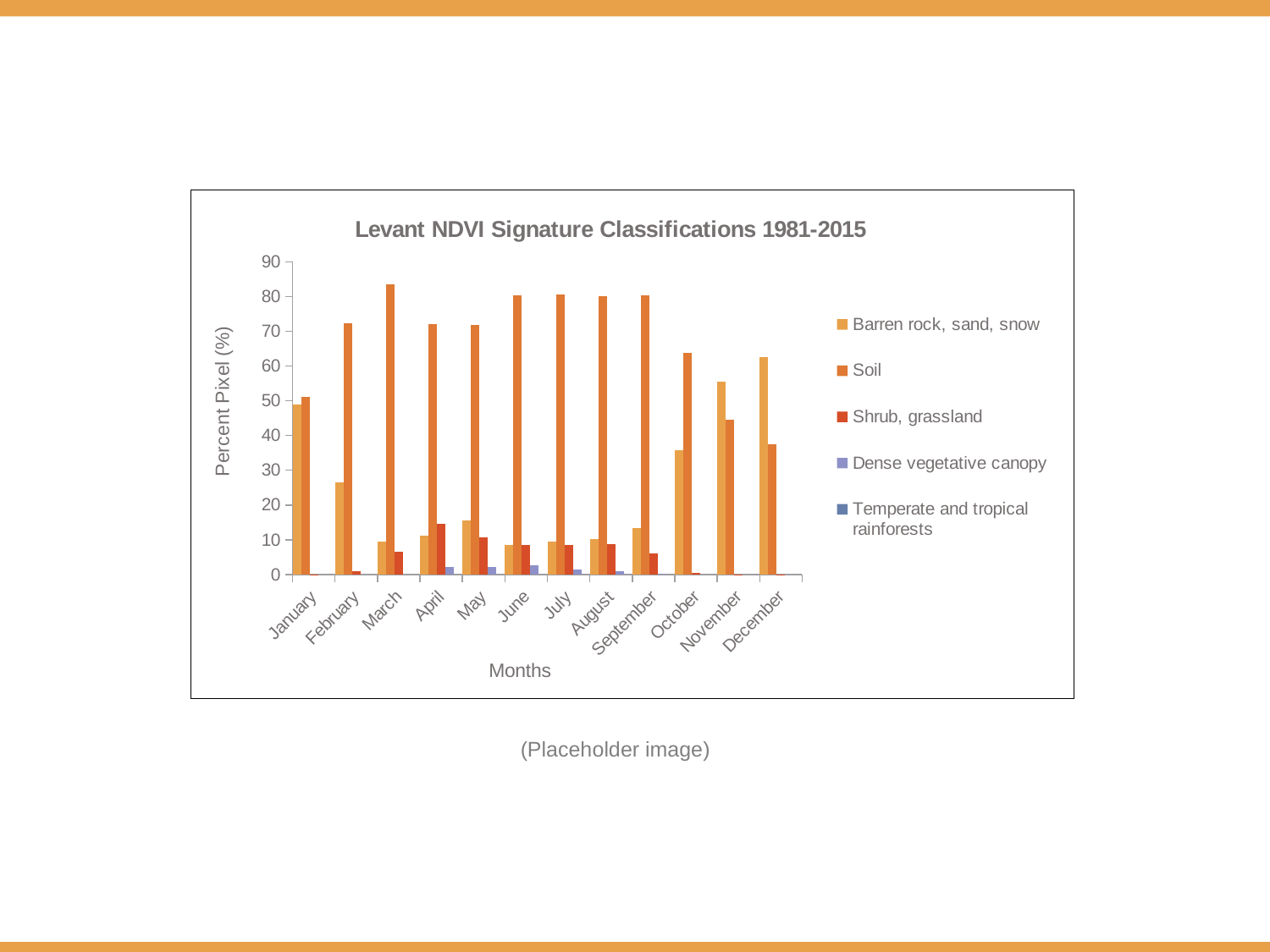
Is the Soil value for March greater or less than 80? greater In which month is the Barren rock, sand, snow value highest? December How many series does the legend list? 5 Is the Shrub, grassland value for April greater or less than 10? greater Does the Barren rock, sand, snow value rise or fall from January to March? Fall In which month is the Shrub, grassland value highest? April How many months are shown on the x axis? 12 In which month is the Soil value highest? March What kind of chart is shown on the slide? Bar chart In December, which is larger: Barren rock, sand, snow or Soil? Barren rock, sand, snow Is the Barren rock, sand, snow value for January greater or less than 40? greater What is the title of the chart? Levant NDVI Signature Classifications 1981-2015